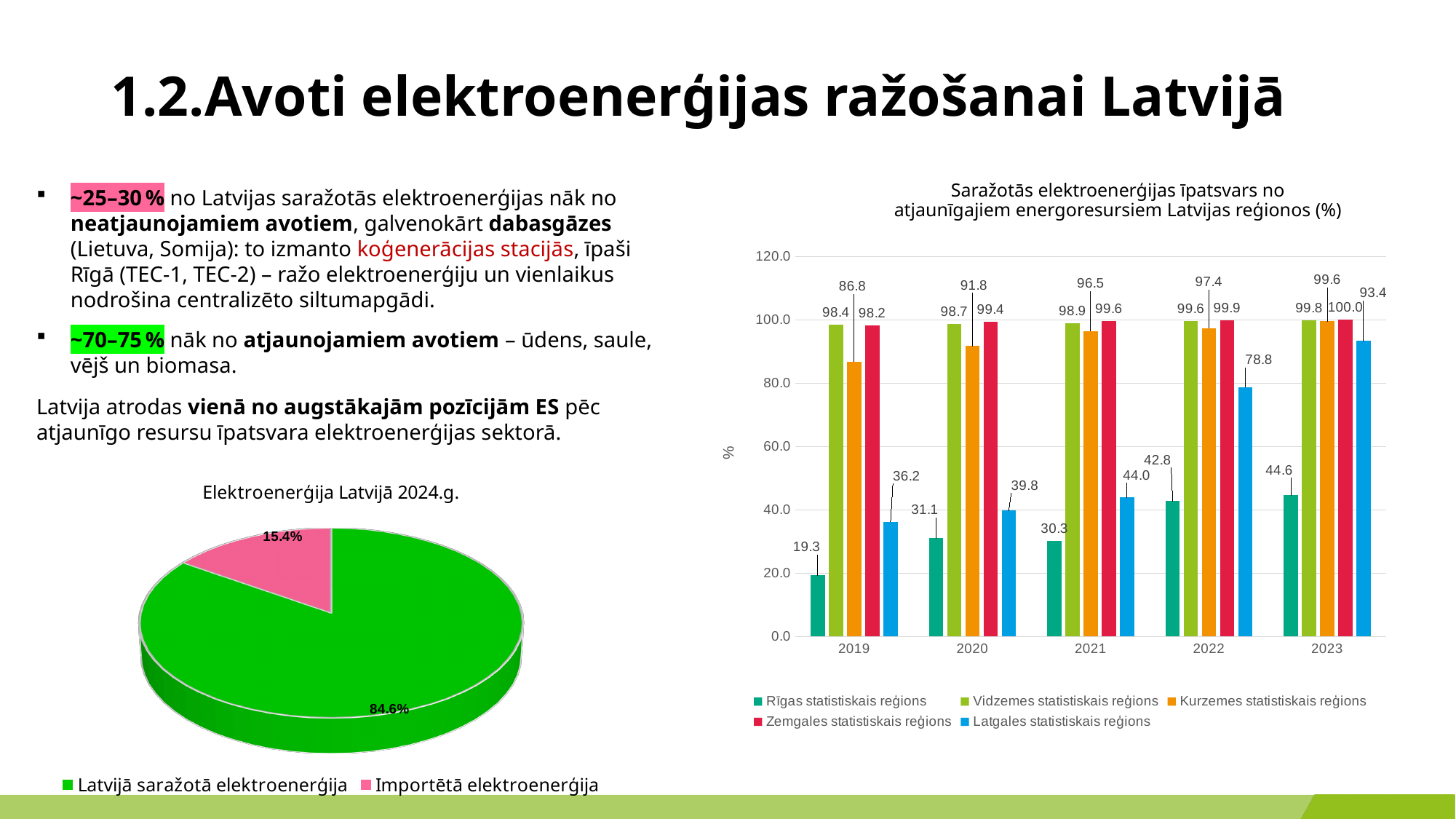
How many series does the legend of the bar chart on the right list? 5 In the bar chart on the right, is the value for Rīgas statistiskais reģions in 2020 greater or less than 40.0? less In the pie chart 'Elektroenerģija Latvijā 2024.g.', what share is 'Importētā elektroenerģija'? 15.4% In the bar chart on the right, which region has the lowest value in 2021? Rīgas statistiskais reģions What kind of chart is 'Elektroenerģija Latvijā 2024.g.'? Pie chart In the bar chart on the right, what is the value for Latgales statistiskais reģions in 2022? 78.8 In the bar chart on the right, does the value for Latgales statistiskais reģions rise or fall from 2019 to 2023? Rise In the bar chart on the right, what is the value for Zemgales statistiskais reģions in 2023? 100.0 In the bar chart on the right, what is the difference between the Kurzemes statistiskais reģions values in 2023 and 2019? 12.8 In the bar chart on the right, which year has the highest value for Latgales statistiskais reģions? 2023 In the bar chart on the right, what is the value for Rīgas statistiskais reģions in 2019? 19.3 In the pie chart 'Elektroenerģija Latvijā 2024.g.', what share is 'Latvijā saražotā elektroenerģija'? 84.6%